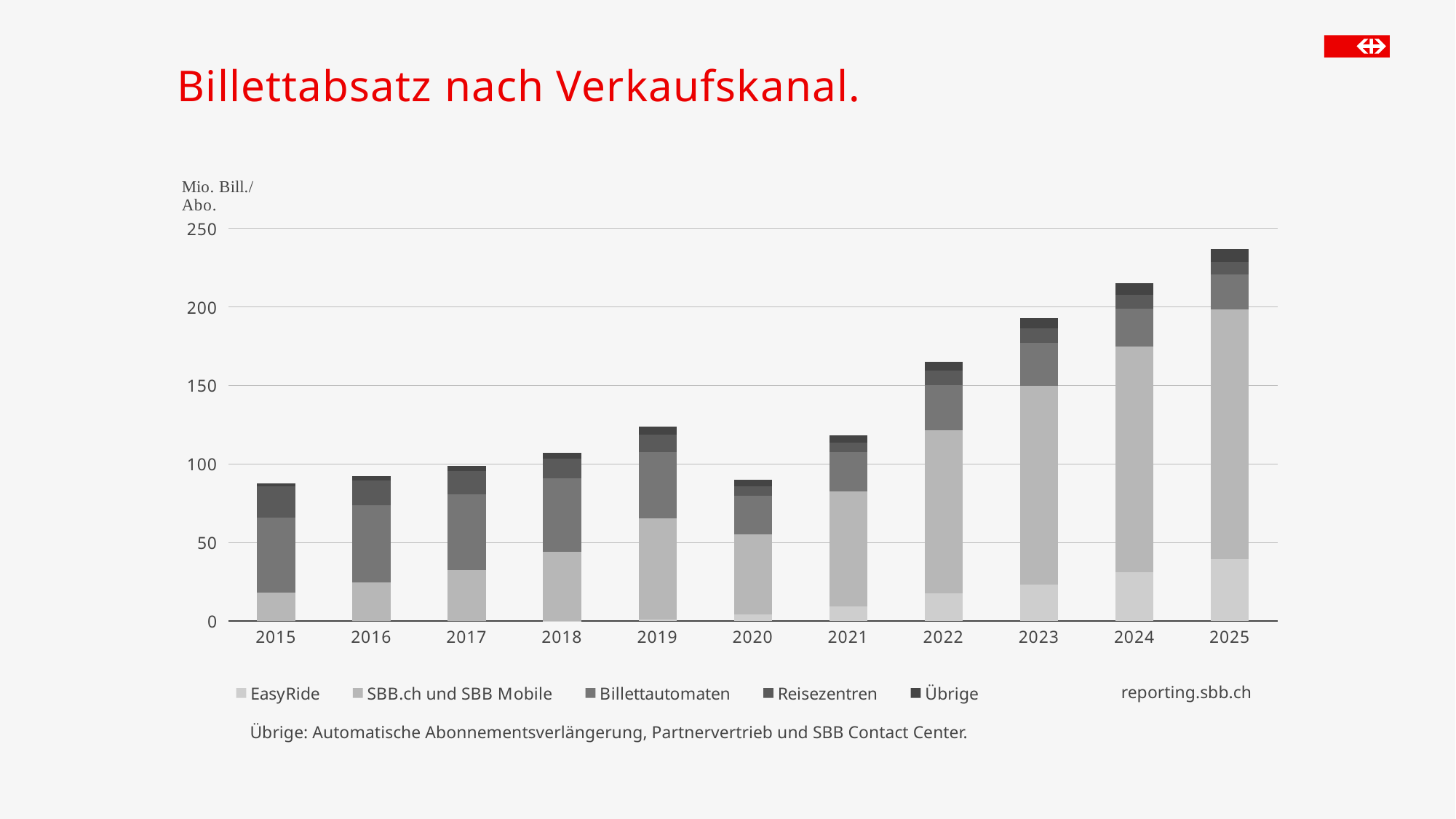
Do the total bars generally rise or fall from 2015 to 2025? rise Is the total bar for 2025 greater or less than 200? greater Is the total bar for 2023 greater or less than 150? greater What is the title of the chart on the slide? Billettabsatz nach Verkaufskanal. Which year has the highest total bar in the chart? 2025 How many series does the chart's legend list? 5 Is the total bar for 2020 greater or less than 100? less How many years are shown on the x axis of the chart? 11 Which total bar is larger, 2023 or 2019? 2023 What kind of chart is shown on the slide? stacked bar chart What is the first series listed in the chart's legend? EasyRide